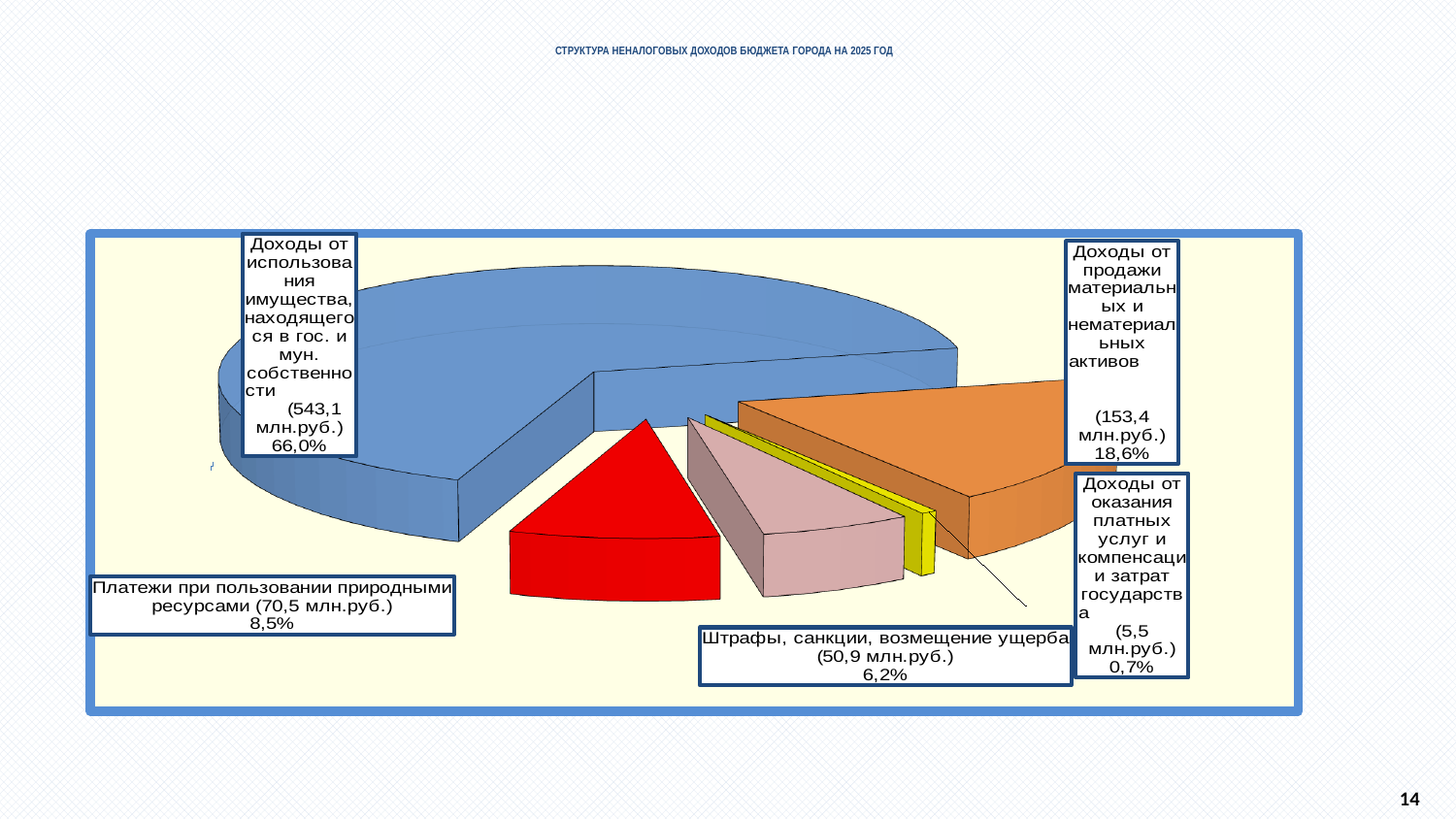
What is the difference in percentage points between the share of "Доходы от продажи материальных и нематериальных активов" and the share of "Штрафы, санкции, возмещение ущерба"? 12,4 Which category has the largest share of the pie? Доходы от использования имущества, находящегося в гос. и мун. собственности Which category has the smallest share of the pie? Доходы от оказания платных услуг и компенсации затрат государства What is the title of the slide? СТРУКТУРА НЕНАЛОГОВЫХ ДОХОДОВ БЮДЖЕТА ГОРОДА НА 2025 ГОД What is the value shown for "Доходы от использования имущества, находящегося в гос. и мун. собственности"? 543,1 млн.руб. What share of the pie does "Доходы от продажи материальных и нематериальных активов" represent? 18,6% What is the value shown for "Доходы от оказания платных услуг и компенсации затрат государства"? 5,5 млн.руб. Which is larger: "Платежи при пользовании природными ресурсами" or "Штрафы, санкции, возмещение ущерба"? Платежи при пользовании природными ресурсами How many slices does the pie chart have? 5 What share of the pie does "Платежи при пользовании природными ресурсами" represent? 8,5% What kind of chart is shown on the slide? Pie chart What is the value shown for "Штрафы, санкции, возмещение ущерба"? 50,9 млн.руб.